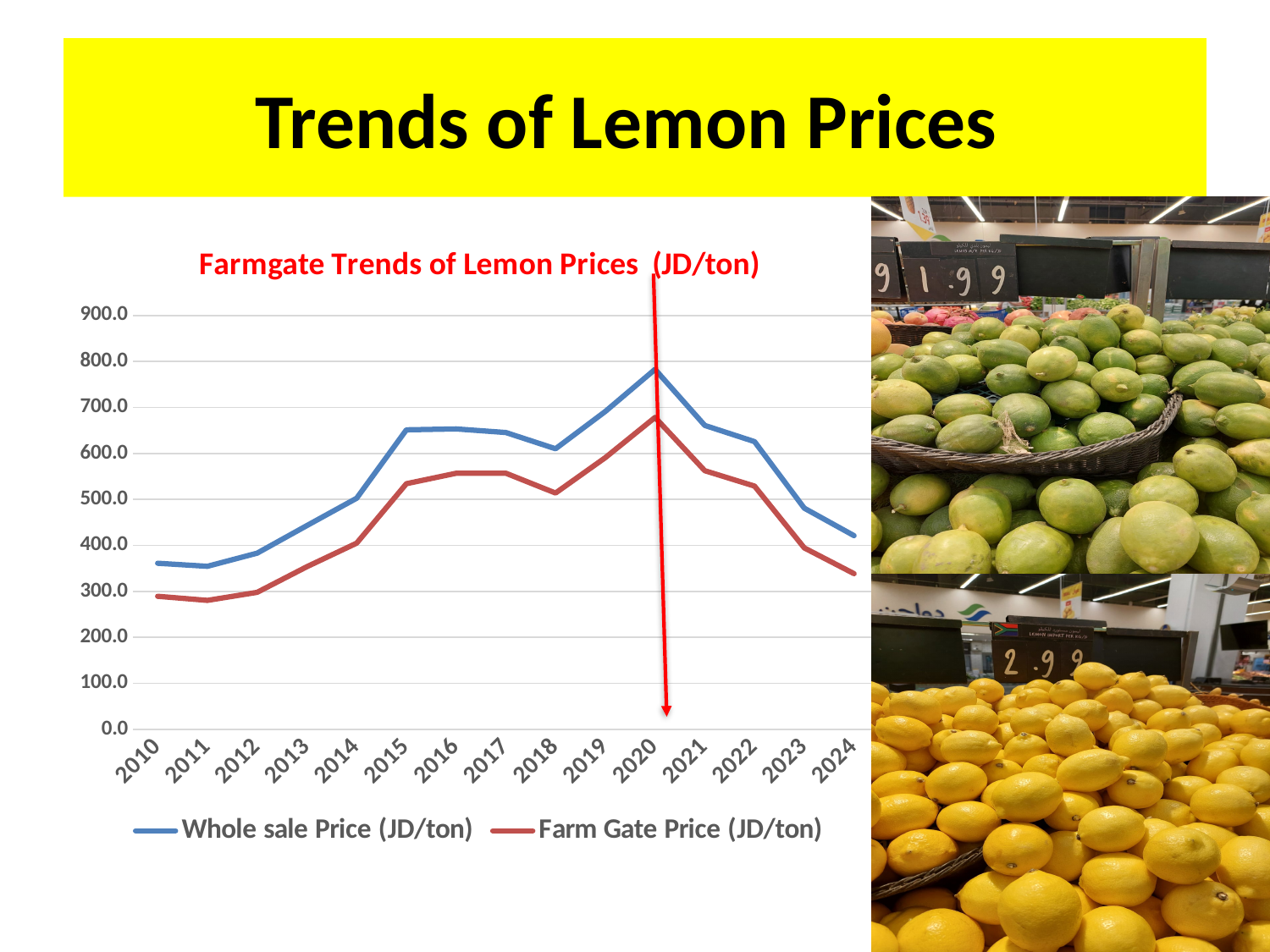
Is the Whole sale Price (JD/ton) in 2010 greater or less than 400? less What is the title of the chart? Farmgate Trends of Lemon Prices (JD/ton) Is the Farm Gate Price (JD/ton) in 2020 greater or less than 600? greater What kind of chart is shown on the slide? Line chart Is the Farm Gate Price (JD/ton) in 2024 greater or less than 400? less In which year does the Farm Gate Price (JD/ton) reach its highest value? 2020 In which year does the Whole sale Price (JD/ton) reach its highest value? 2020 In 2020, which is larger: the Whole sale Price (JD/ton) or the Farm Gate Price (JD/ton)? Whole sale Price (JD/ton) Does the Whole sale Price (JD/ton) rise or fall from 2020 to 2024? Fall How many series does the chart's legend list? 2 How many years are plotted along the x axis of the chart? 15